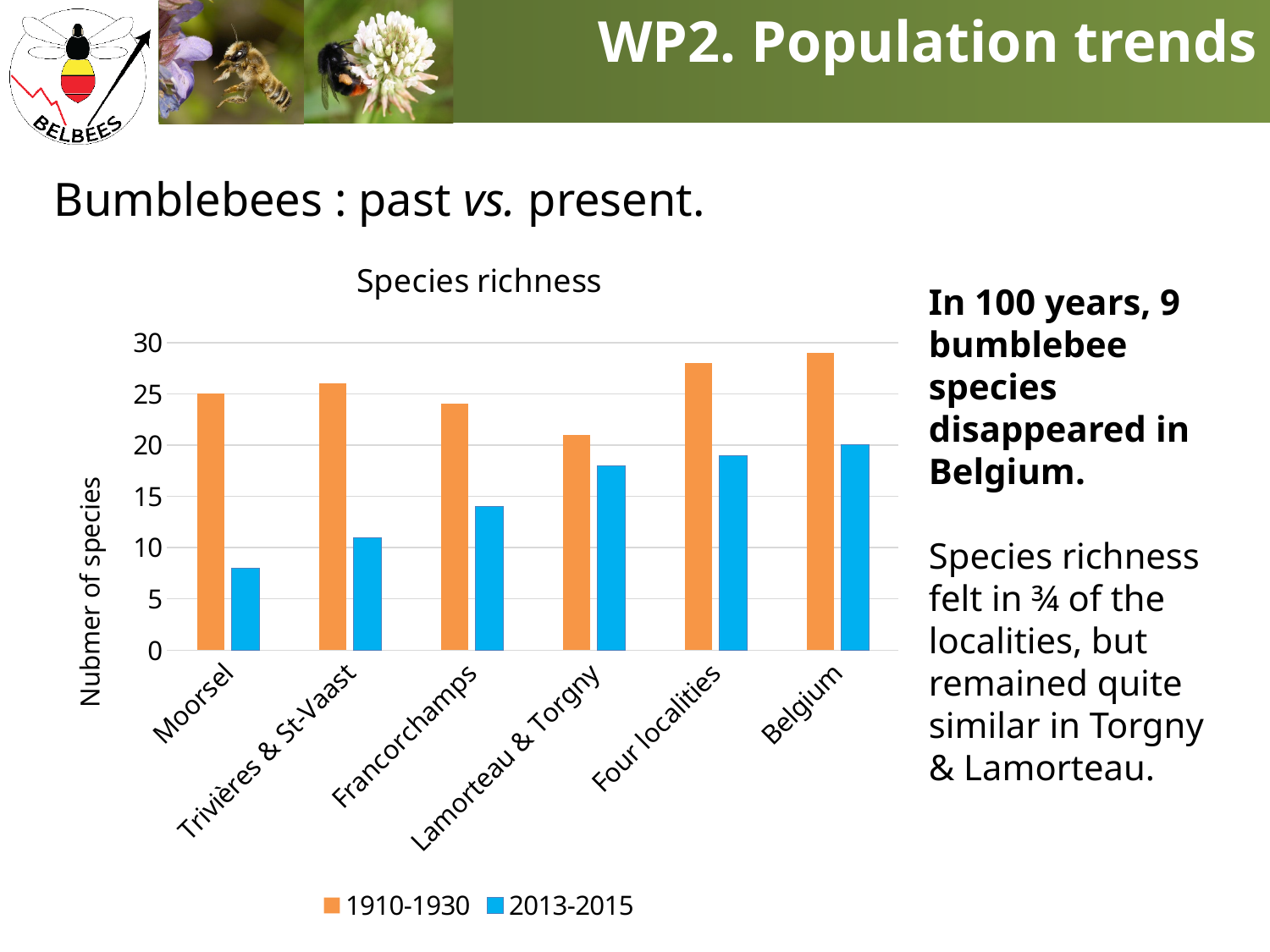
What type of chart is shown on the slide? bar chart For Trivières & St-Vaast, which series has the larger value, 1910-1930 or 2013-2015? 1910-1930 Is the 1910-1930 value for Four localities greater or less than 25? greater What is the label of the vertical axis of the chart? Nubmer of species How many series does the legend of the Species richness chart list? 2 Which category has the highest 1910-1930 value in the Species richness chart? Belgium Is the 2013-2015 value for Francorchamps greater or less than 15? less How many categories are shown on the x axis of the Species richness chart? 6 What is the title of the chart on the slide? Species richness Is the 2013-2015 value for Lamorteau & Torgny greater or less than 15? greater Which category has the lowest 2013-2015 value in the Species richness chart? Moorsel